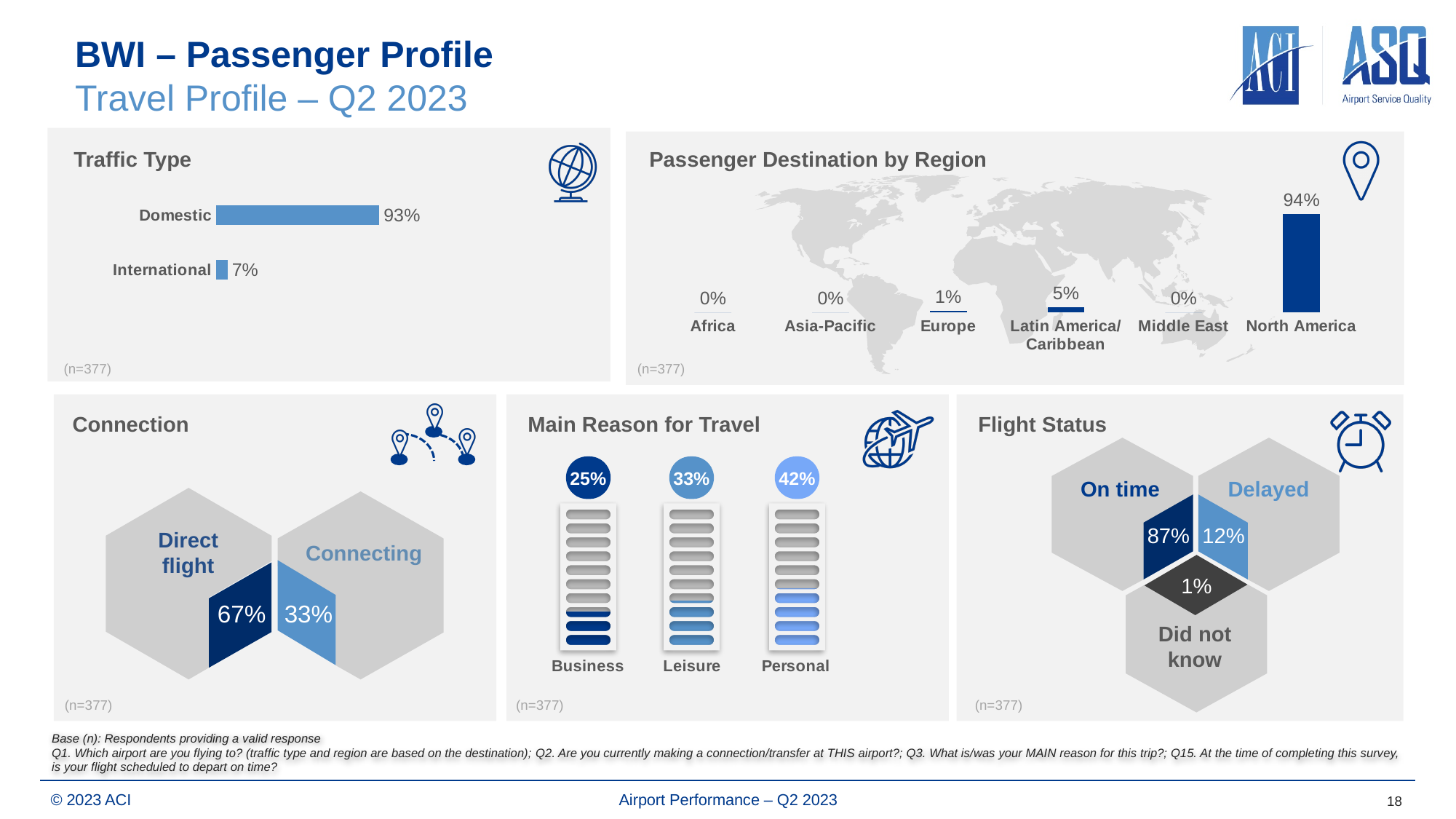
In the Passenger Destination by Region chart, which region has the highest percentage? North America In the Flight Status chart, what percentage of flights are Delayed? 12% In the Main Reason for Travel chart, which reason has the highest percentage? Personal What type of chart is the Traffic Type chart? Bar chart In the Traffic Type chart, what is the difference between the Domestic and International percentages? 86% In the Passenger Destination by Region chart, what is the value for Europe? 1% How many regions are shown in the Passenger Destination by Region chart? 6 In the Passenger Destination by Region chart, what is the value for Latin America/Caribbean? 5% In the Traffic Type chart, what percentage of passengers are Domestic? 93% In the Main Reason for Travel chart, what is the value for Leisure? 33% In the Connection chart, what percentage of passengers are on a Direct flight? 67% In the Traffic Type chart, what percentage of passengers are International? 7%